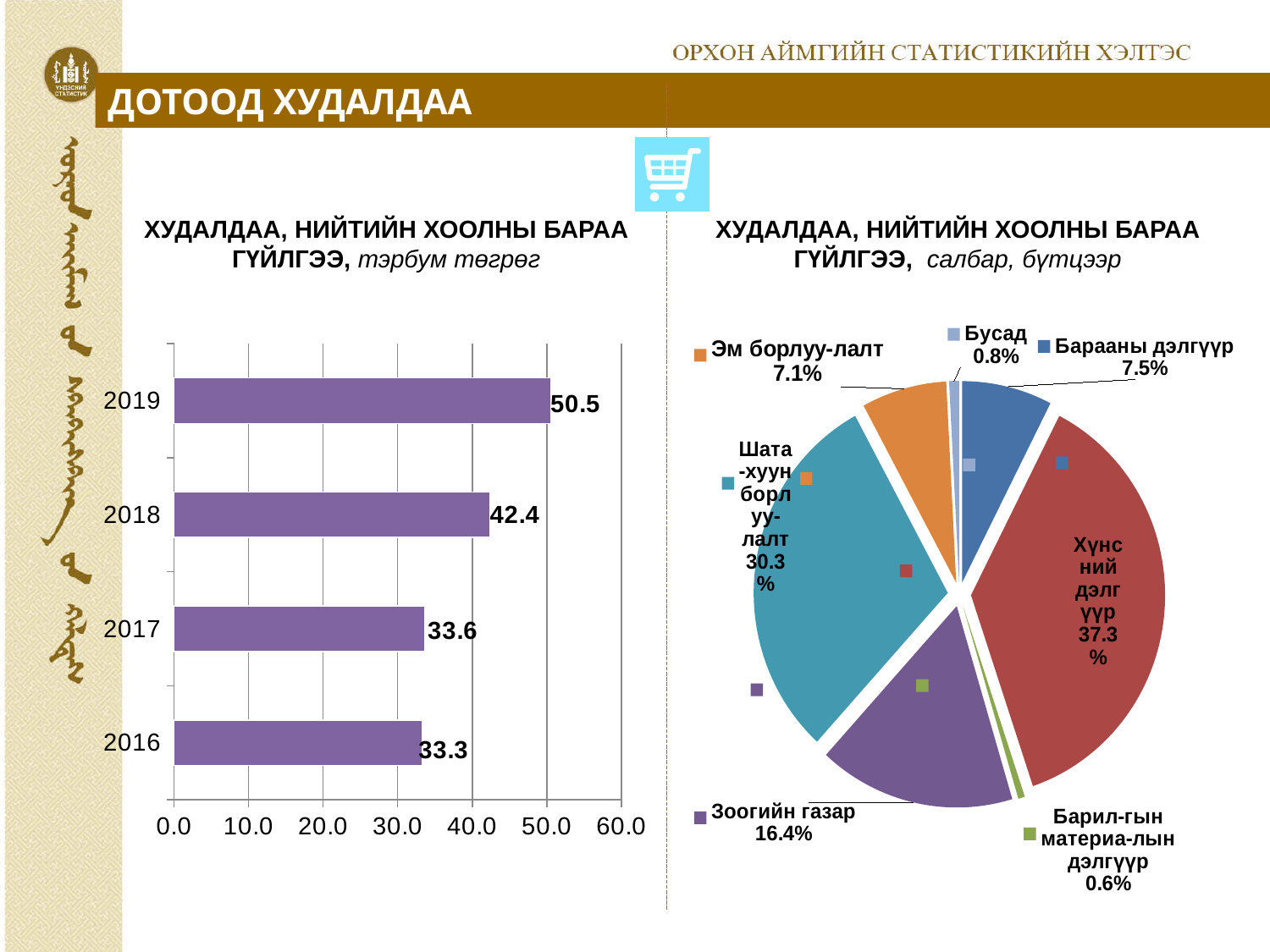
On the right pie chart, how many slices are there? 7 On the right pie chart, what share does Зоогийн газар have? 16.4% On the left bar chart, what is the value for 2017? 33.6 On the left bar chart, what is the value for 2019? 50.5 On the left bar chart, which year has the lowest value? 2016 What kind of chart is the chart on the left of the slide? bar chart On the right pie chart, which category has the smallest share? Барилгын материалын дэлгүүр On the left bar chart, do the values rise or fall from 2016 to 2019? rise On the left bar chart, what is the difference between the values for 2019 and 2018? 8.1 On the left bar chart, how many years are shown? 4 On the right pie chart, what share does Хүнсний дэлгүүр have? 37.3% On the left bar chart, which year has the highest value? 2019